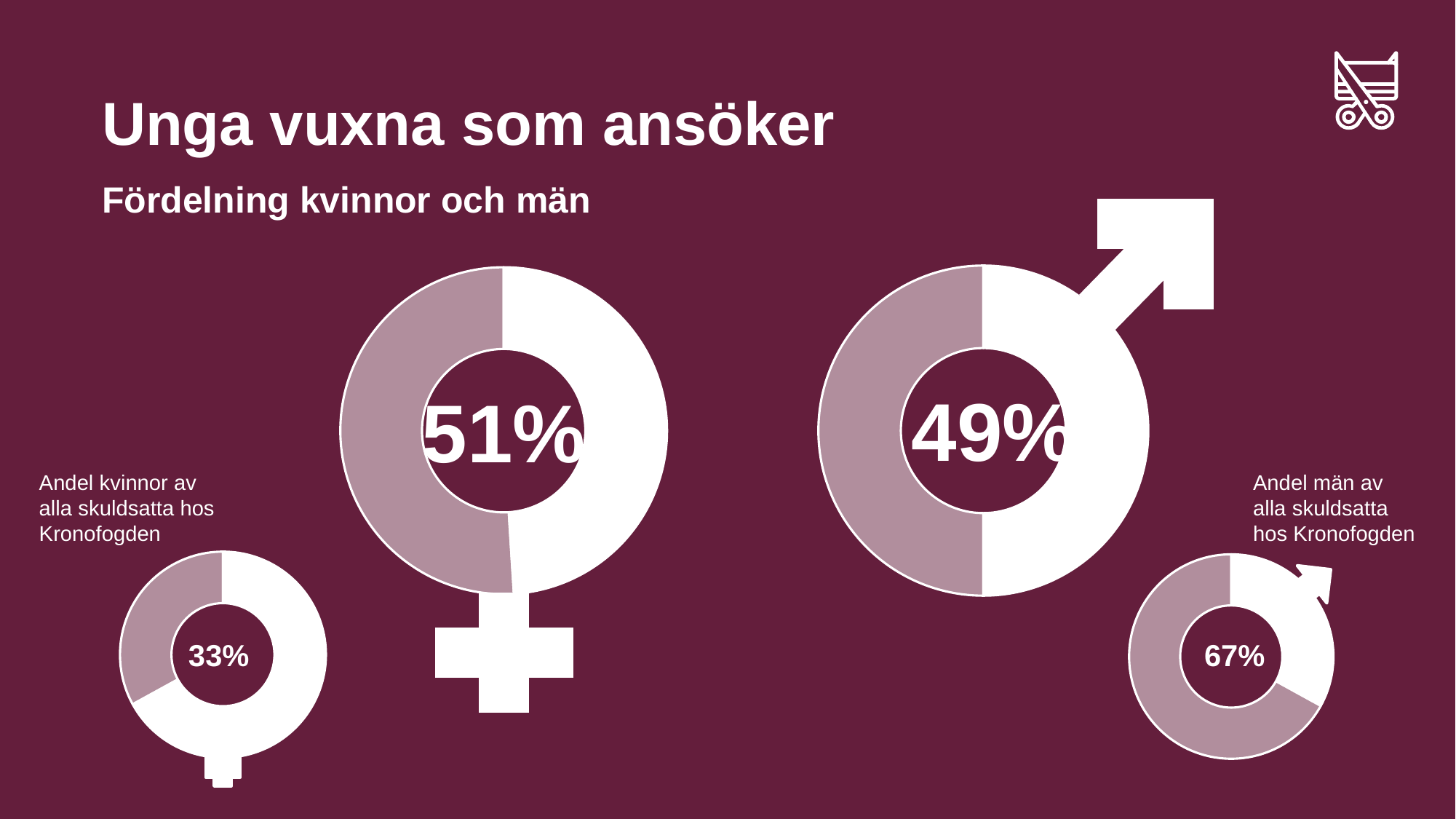
Which of the two small donut charts at the bottom shows the higher value? Andel män av alla skuldsatta hos Kronofogden (67%) What is the difference between the small male donut chart value (67%) and the small female donut chart value (33%)? 34 percentage points In the small donut chart labelled 'Andel kvinnor av alla skuldsatta hos Kronofogden', what value is shown? 33% Which is larger: the value in the large female donut chart or the value in the large male donut chart? the large female donut chart (51%) What percentage is shown in the large donut chart with the female symbol? 51% What is the subtitle of the slide, shown below 'Unga vuxna som ansöker'? Fördelning kvinnor och män In the small donut chart labelled 'Andel män av alla skuldsatta hos Kronofogden', what value is shown? 67% What is the sum of the values in the two large donut charts (51% and 49%)? 100% What kind of chart is used to show the 51% and 49% values on the slide? donut (pie) chart What percentage is shown in the large donut chart with the male symbol? 49% How many donut charts are shown on the slide? 4 What is the difference between the value in the large female donut chart (51%) and the large male donut chart (49%)? 2 percentage points